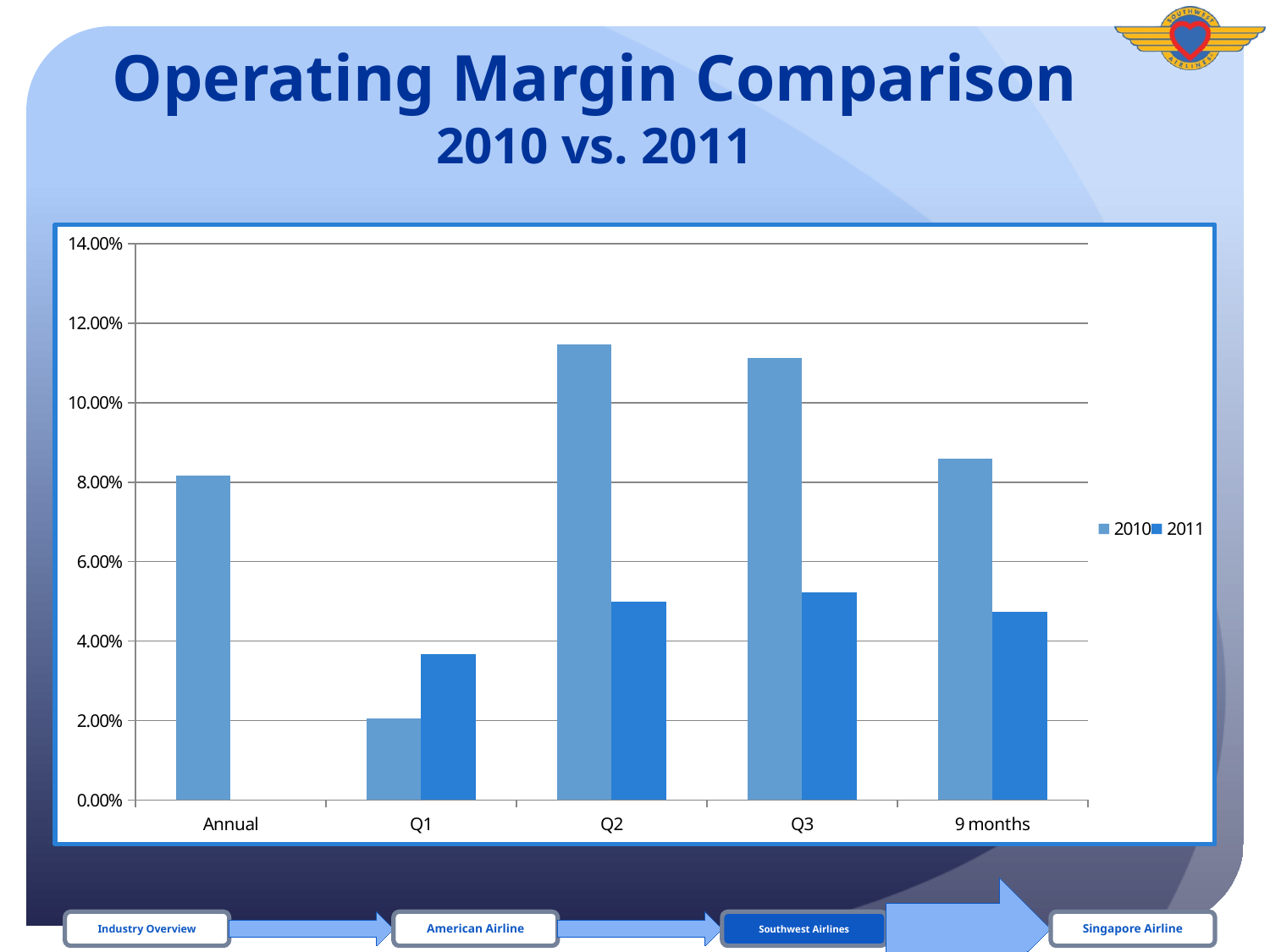
Is the 2011 value for Q3 greater or less than 6.00%? less What is the title of the slide containing the chart? Operating Margin Comparison 2010 vs. 2011 How many categories are shown on the x axis? 5 How many series does the legend list? 2 Which category has the lowest value for the 2010 series? Q1 Is the 2010 value for 9 months greater or less than 8.00%? greater Is the 2010 value for Q2 greater or less than 10.00%? greater Which category has the lowest value for the 2011 series? Q1 What kind of chart is shown on the slide? bar chart For Q1, which series has the larger value, 2010 or 2011? 2011 For Q2, which series has the larger value, 2010 or 2011? 2010